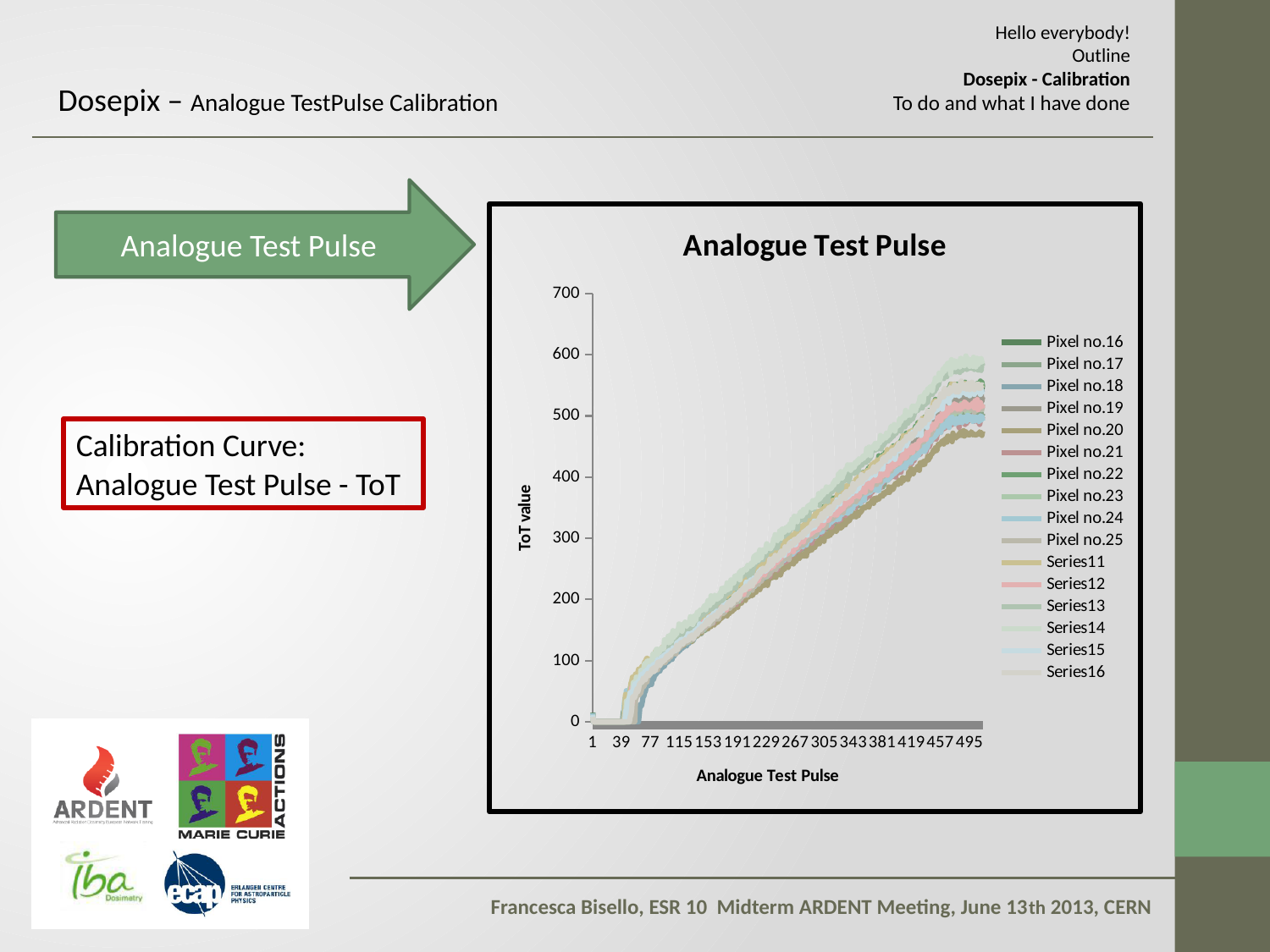
What is the title of the chart? Analogue Test Pulse What is the label of the vertical axis of the chart? ToT value Is the ToT value of the lines at Analogue Test Pulse 115 greater or less than 300? less Is the ToT value for Pixel no.16 at the right end of the chart (Analogue Test Pulse 495) greater or less than 400? greater What is the highest tick value shown on the vertical axis of the chart? 700 Is the ToT value of the lines at Analogue Test Pulse 1 greater or less than 100? less How many series does the chart's legend list? 16 What kind of chart is shown on the slide? line chart Do the ToT values rise or fall as the Analogue Test Pulse increases along the x axis? rise